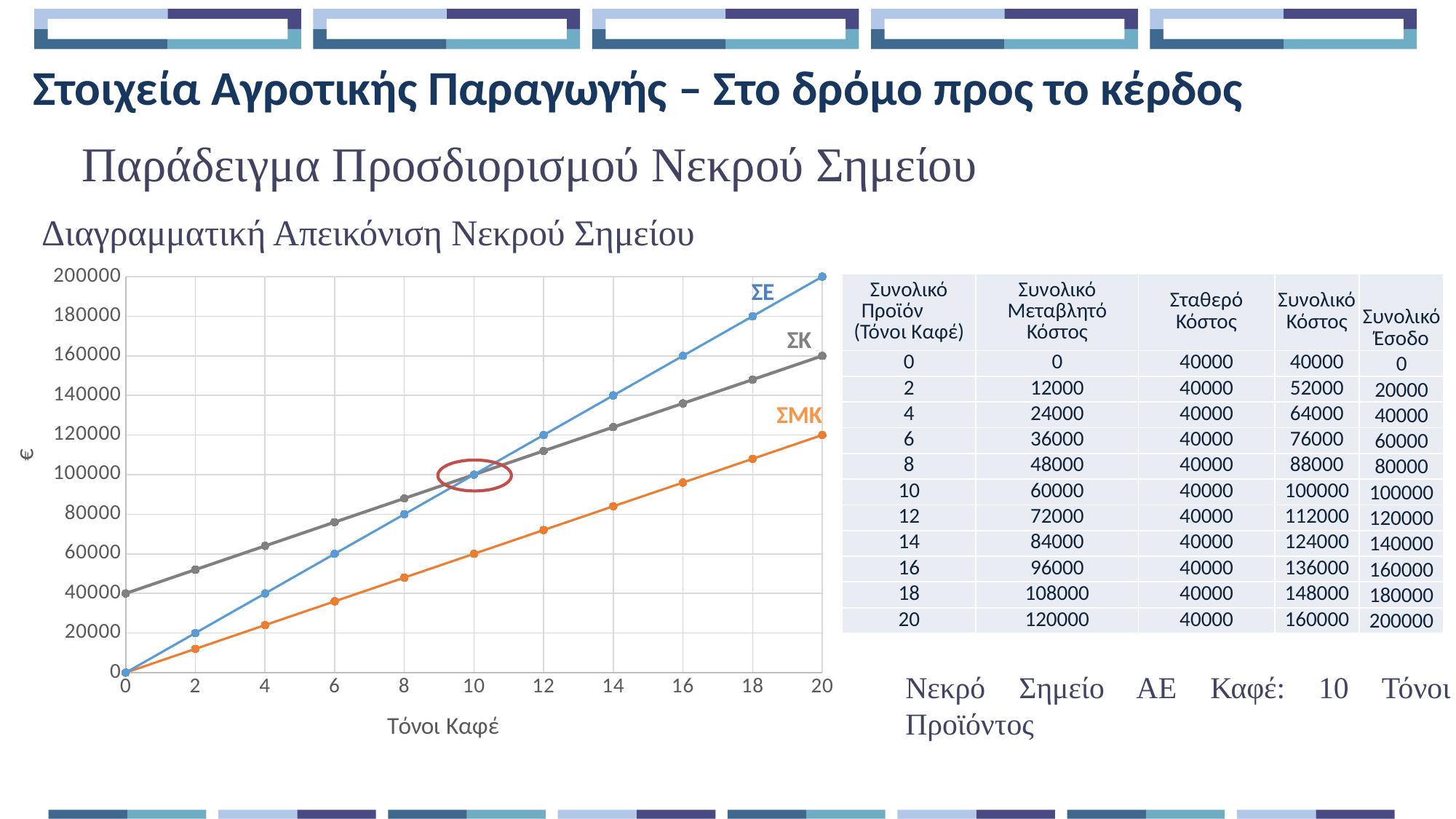
What is the value of ΣΚ (Συνολικό Κόστος) at 0 Τόνοι Καφέ? 40000 How many series are plotted on the chart? 3 What is the value of ΣΕ (Συνολικό Έσοδο) at 20 Τόνοι Καφέ? 200000 How many data points are plotted on each line? 11 What is the difference between ΣΕ and ΣΚ at 20 Τόνοι Καφέ? 40000 Does the ΣΜΚ line rise or fall as Τόνοι Καφέ increases? rise What are the labels of the three lines on the chart? ΣΕ, ΣΚ, ΣΜΚ At how many Τόνοι Καφέ do the ΣΕ and ΣΚ lines intersect (the circled point)? 10 What kind of chart is shown on the slide? line chart Which of the three lines has the highest value at 20 Τόνοι Καφέ? ΣΕ What is the value of ΣΜΚ (Συνολικό Μεταβλητό Κόστος) at 10 Τόνοι Καφέ? 60000 Which line has the higher value at 4 Τόνοι Καφέ, ΣΕ or ΣΚ? ΣΚ